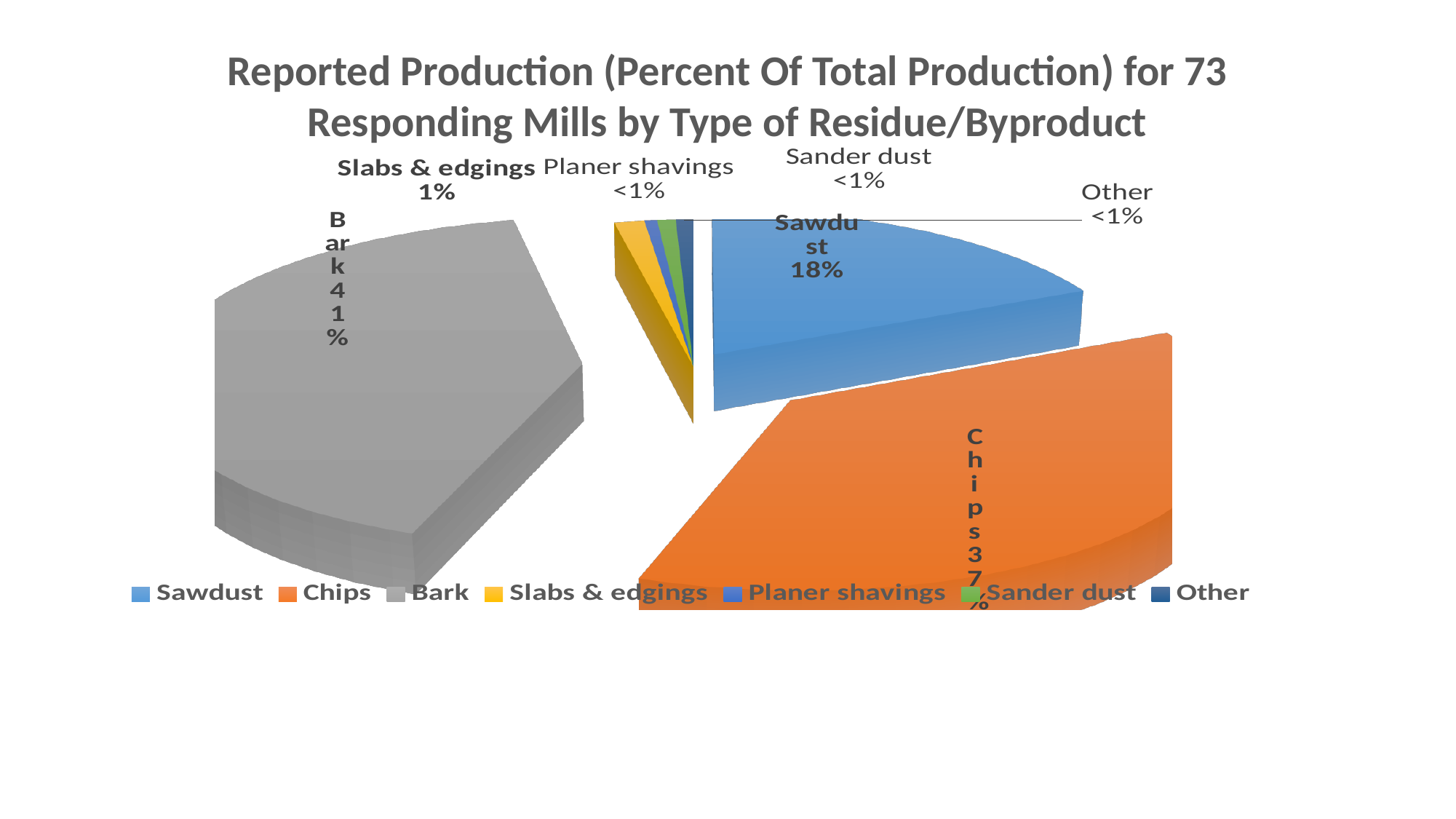
What colour represents Chips in the pie chart? Orange What kind of chart is shown on the slide? Pie chart What percentage is shown for Slabs & edgings? 1% Which is larger, the share for Bark or the share for Chips? Bark How many percentage points larger is the Bark share than the Chips share? 4 What percentage of total production is Bark? 41% How many percentage points larger is the Chips share than the Sawdust share? 19 Which residue/byproduct type has the largest share of total production? Bark What percentage of total production is Sawdust? 18% What value is shown for Planer shavings? <1% How many residue/byproduct categories does the pie chart show? 7 What percentage of total production is Chips? 37%